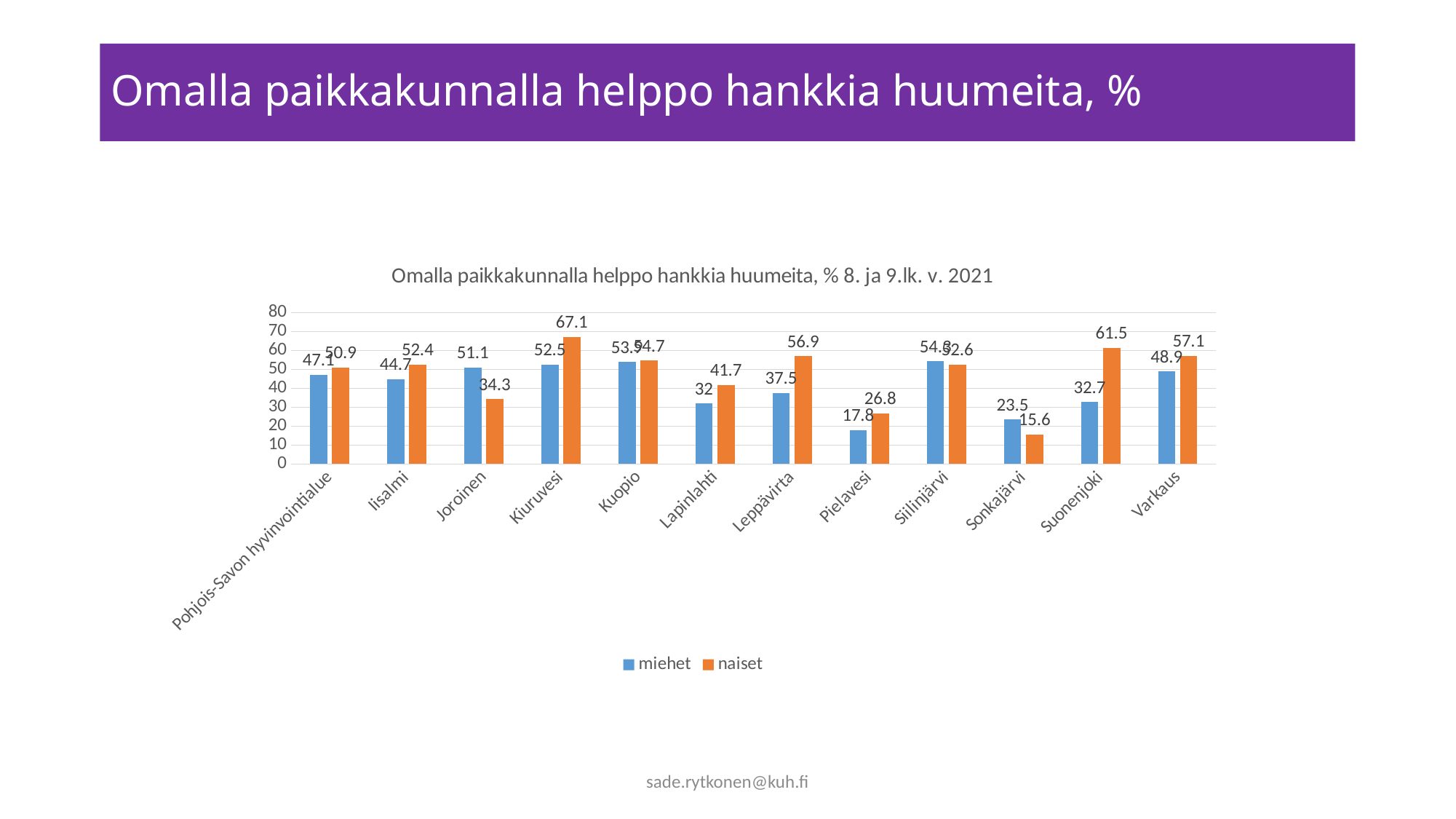
How many series does the legend list? 2 Which category has the lowest naiset value? Sonkajärvi How many categories are shown on the x axis? 12 What is the naiset value for Suonenjoki? 61.5 Which category has the lowest miehet value? Pielavesi What is the naiset value for Kiuruvesi? 67.1 Which is larger for Joroinen, the miehet value or the naiset value? miehet What is the miehet value for Lapinlahti? 32 What kind of chart is shown on the slide? bar chart What is the difference between the naiset and miehet values for Suonenjoki? 28.8 Which category has the highest naiset value? Kiuruvesi What is the miehet value for Pielavesi? 17.8